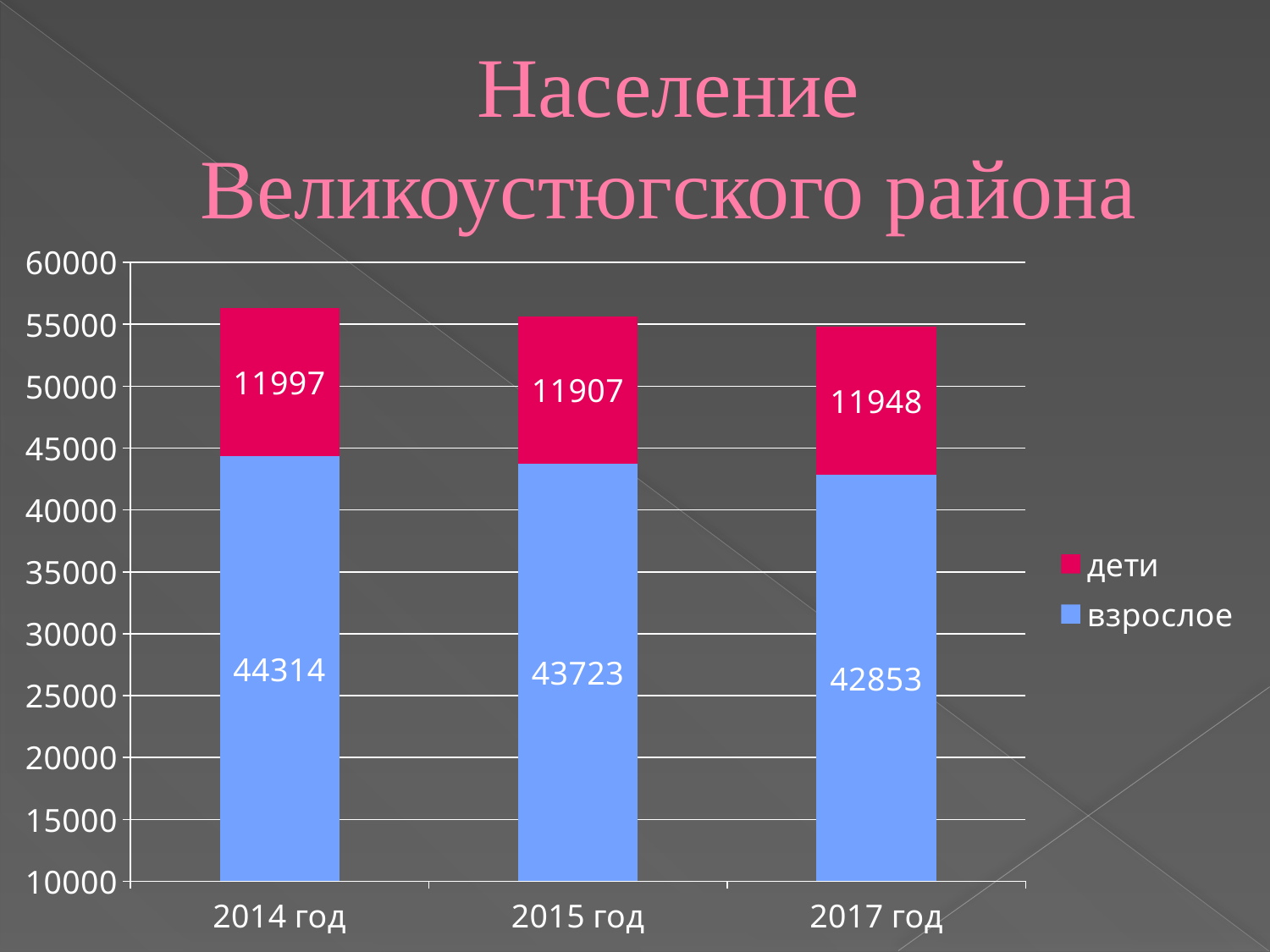
What is the value for взрослое in 2014 год? 44314 How many years are shown on the x axis? 3 What kind of chart is shown on the slide? Stacked bar chart In which year is the взрослое value the highest? 2014 год What is the value for взрослое in 2017 год? 42853 How many series does the legend list? 2 What is the value for дети in 2015 год? 11907 Which is larger: the дети value for 2014 год or for 2017 год? 2014 год What is the difference between the взрослое values for 2014 год and 2017 год? 1461 In which year is the дети value the lowest? 2015 год What is the total of the stacked bar for 2015 год? 55630 What is the value for дети in 2017 год? 11948